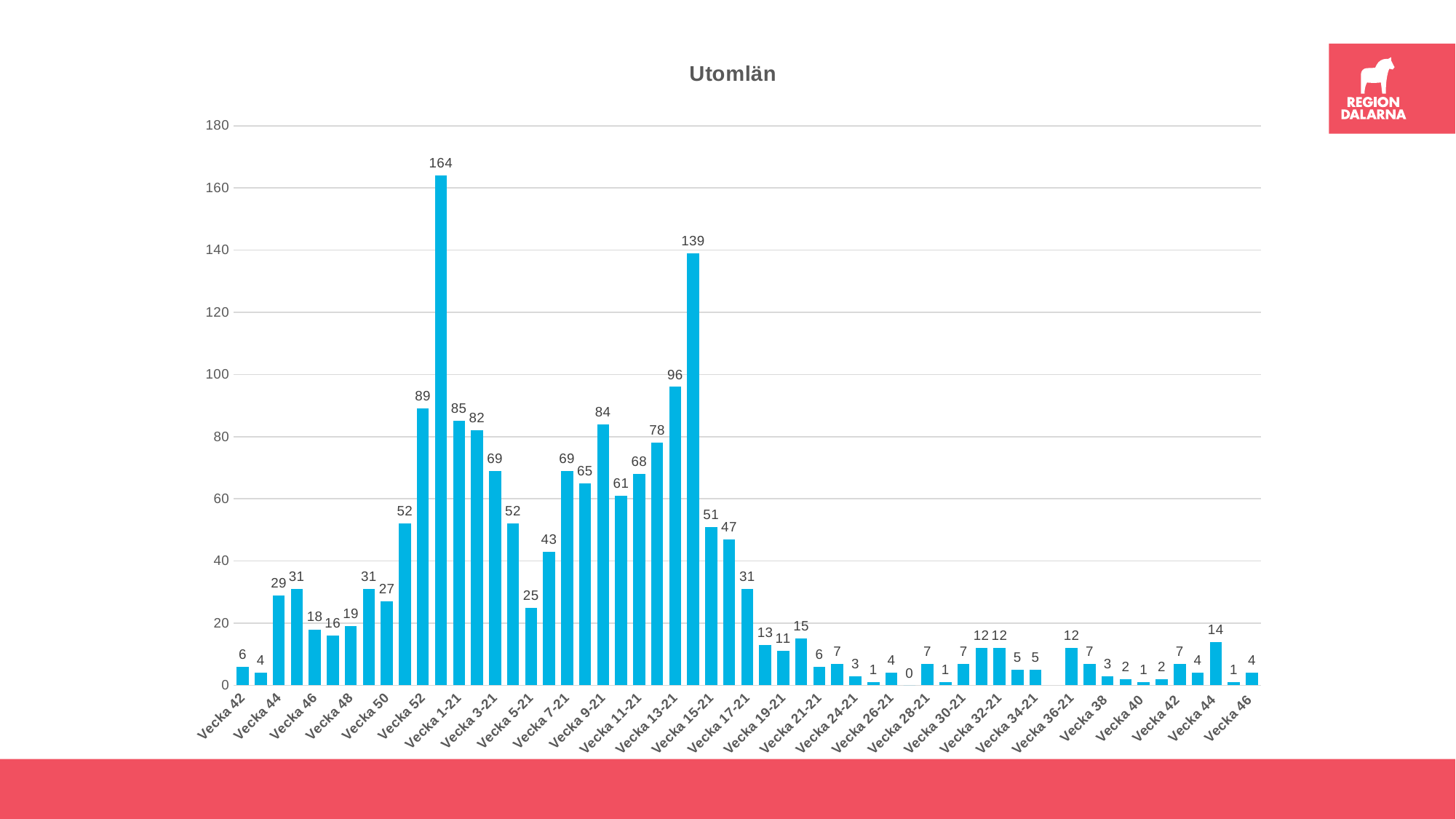
What is the value for Vecka 44 (the first occurrence, near the left of the chart)? 29 What is the highest value shown on the chart? 164 What is the difference between the two tallest bars, 164 and 139? 25 What is the value for Vecka 13-21? 96 What is the value for the first Vecka 42 bar (leftmost bar)? 6 What type of chart is shown on the slide? bar chart Do the values generally rise or fall from Vecka 13-21 to Vecka 21-21? fall What is the value for Vecka 9-21? 84 Is the value for Vecka 1-21 greater or less than 80? greater Which is larger, the value for Vecka 13-21 or the value for Vecka 15-21? Vecka 13-21 What is the title of the chart? Utomlän What is the value for Vecka 46 at the far right of the chart (the last bar)? 4